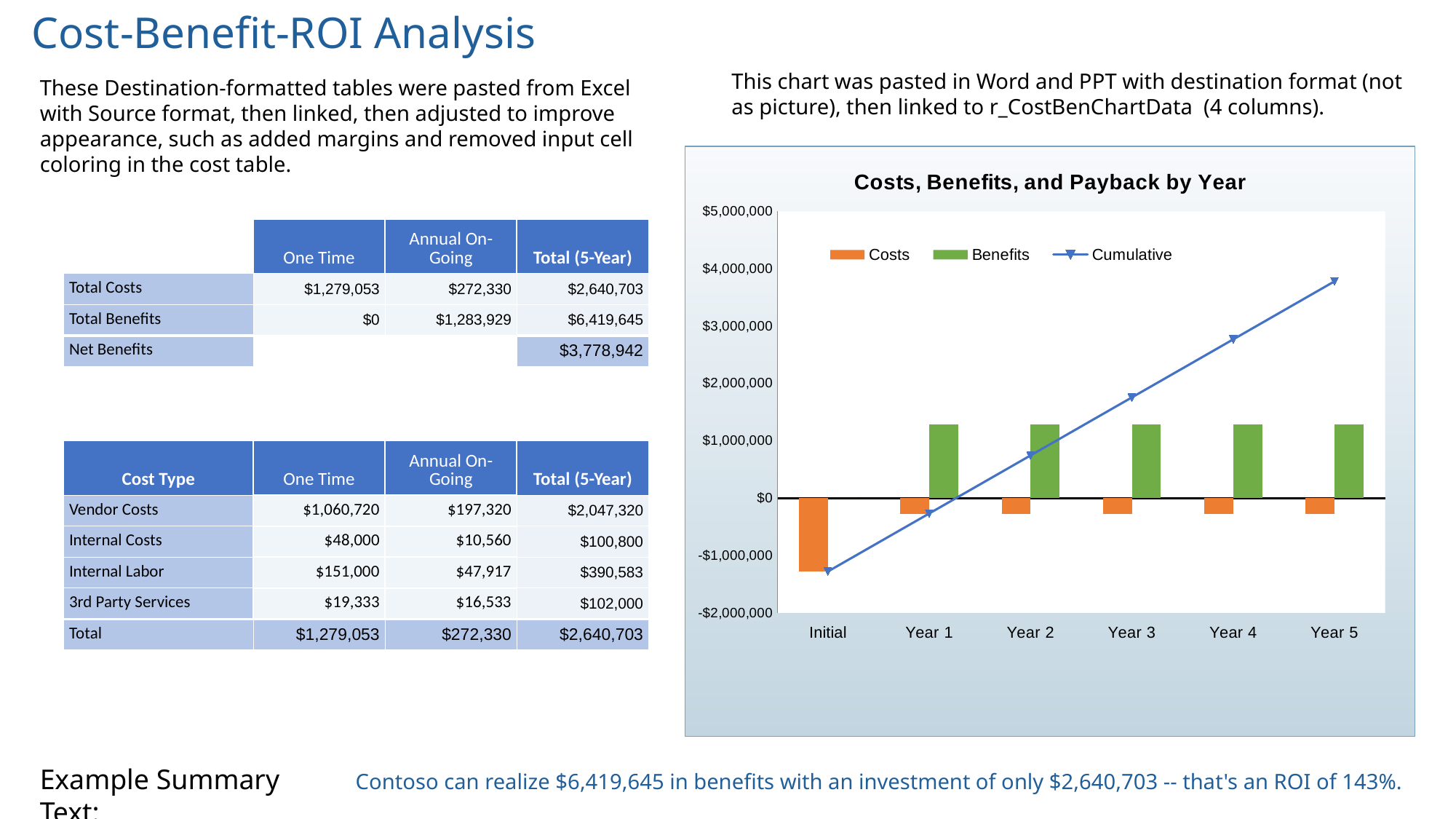
Is the Benefits value for Year 1 greater or less than $1,000,000? greater What kind of chart is used to plot the Costs and Benefits series? bar chart What is the title of the chart on the slide? Costs, Benefits, and Payback by Year Is the Cumulative value for Year 5 greater or less than $3,000,000? greater Does the Cumulative line rise or fall from Initial to Year 5? rises Is the Cumulative value for Year 1 greater or less than $0? less Which colour represents the Benefits series in the chart? green How many categories are shown on the x axis of the chart? 6 What kind of chart is used to plot the Cumulative series? line chart How many series does the chart legend list? 3 Which category has the largest Costs bar (furthest below zero)? Initial